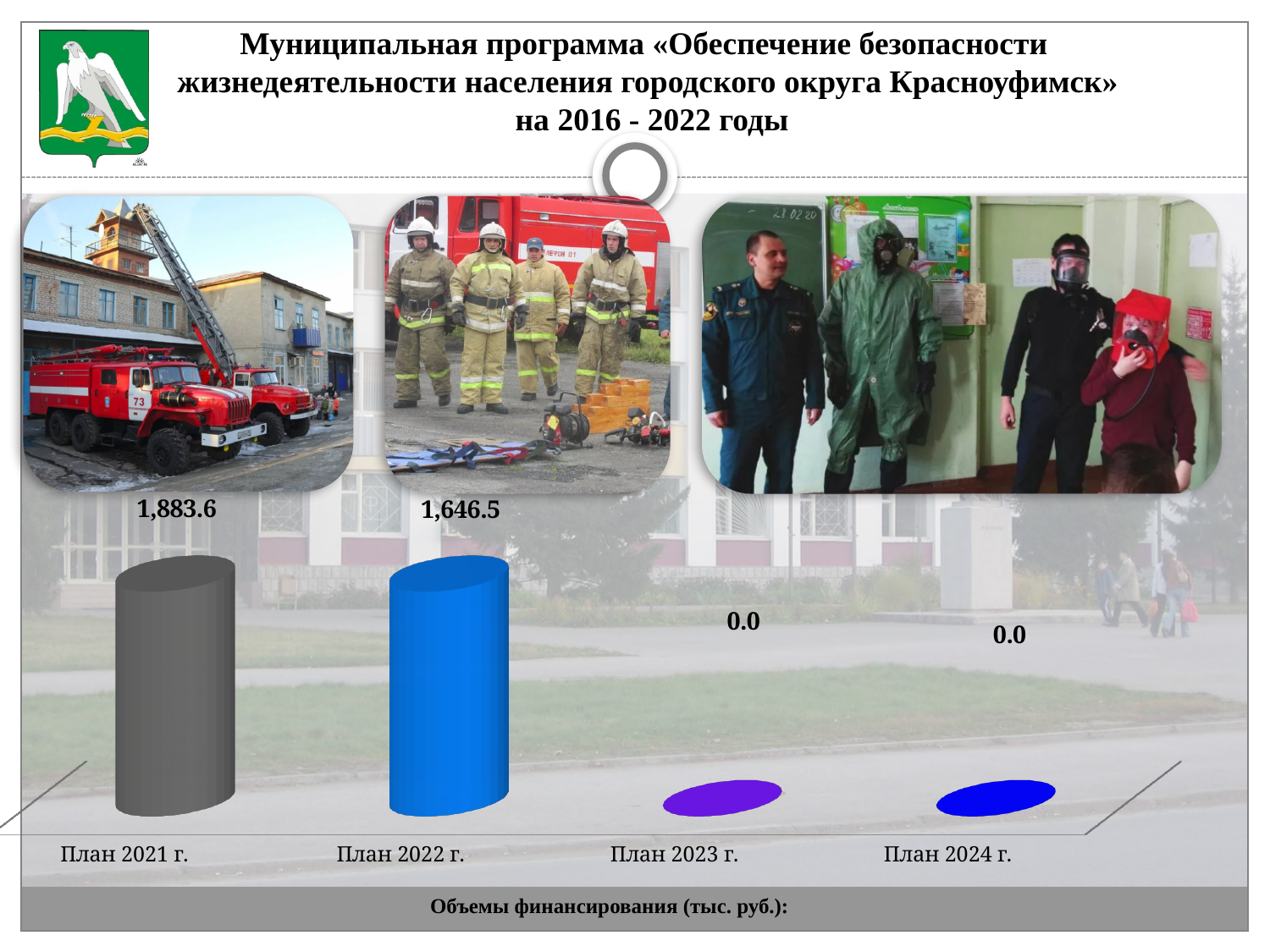
Do the values rise or fall from План 2021 г. to План 2024 г.? Fall What is the value for План 2021 г.? 1,883.6 What is the value for План 2022 г.? 1,646.5 Which category has the highest value? План 2021 г. What is the total of the values for all four categories? 3,530.1 In what units are the financing volumes given, according to the caption below the chart? тыс. руб. What is the value for План 2024 г.? 0.0 What kind of chart is shown on the slide? Bar chart How many categories are shown in the chart? 4 Which is larger, the value for План 2021 г. or the value for План 2022 г.? План 2021 г. What is the value for План 2023 г.? 0.0 What is the difference between the values for План 2021 г. and План 2022 г.? 237.1